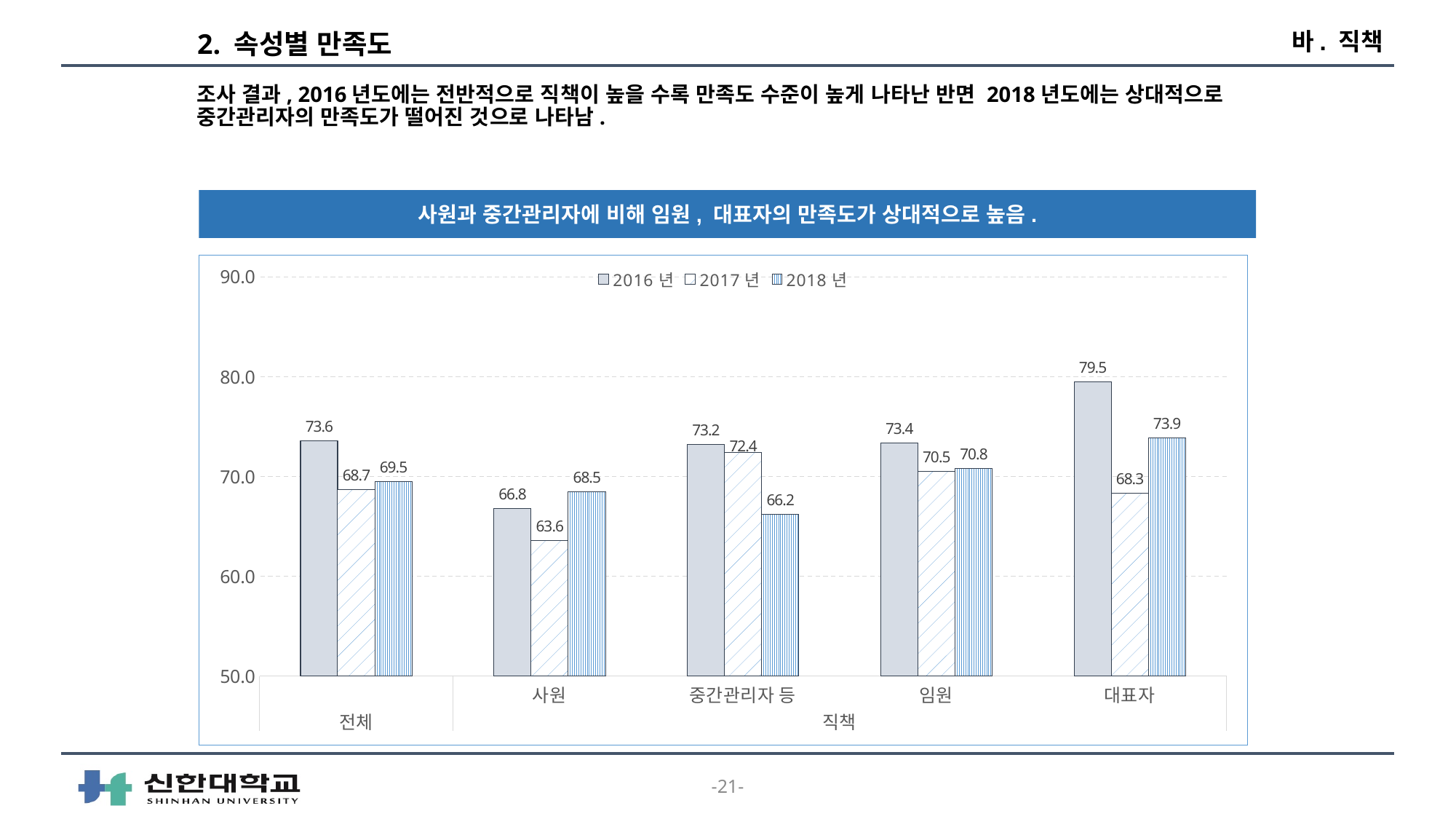
How many series does the legend list? 3 Which is larger for 임원: the 2017 년 value or the 2018 년 value? 2018 년 Which category has the lowest 2017 년 value? 사원 What is the 2017 년 value for 사원? 63.6 What kind of chart is shown on the slide? bar chart What is the difference between the 2016 년 and 2017 년 values for 대표자? 11.2 Which category has the highest 2016 년 value? 대표자 Is the 2016 년 value for 사원 greater or less than 70.0? less What is the 2018 년 value for 전체? 69.5 How many categories are shown on the x axis? 5 What is the 2018 년 value for 중간관리자 등? 66.2 What is the 2016 년 value for 대표자? 79.5